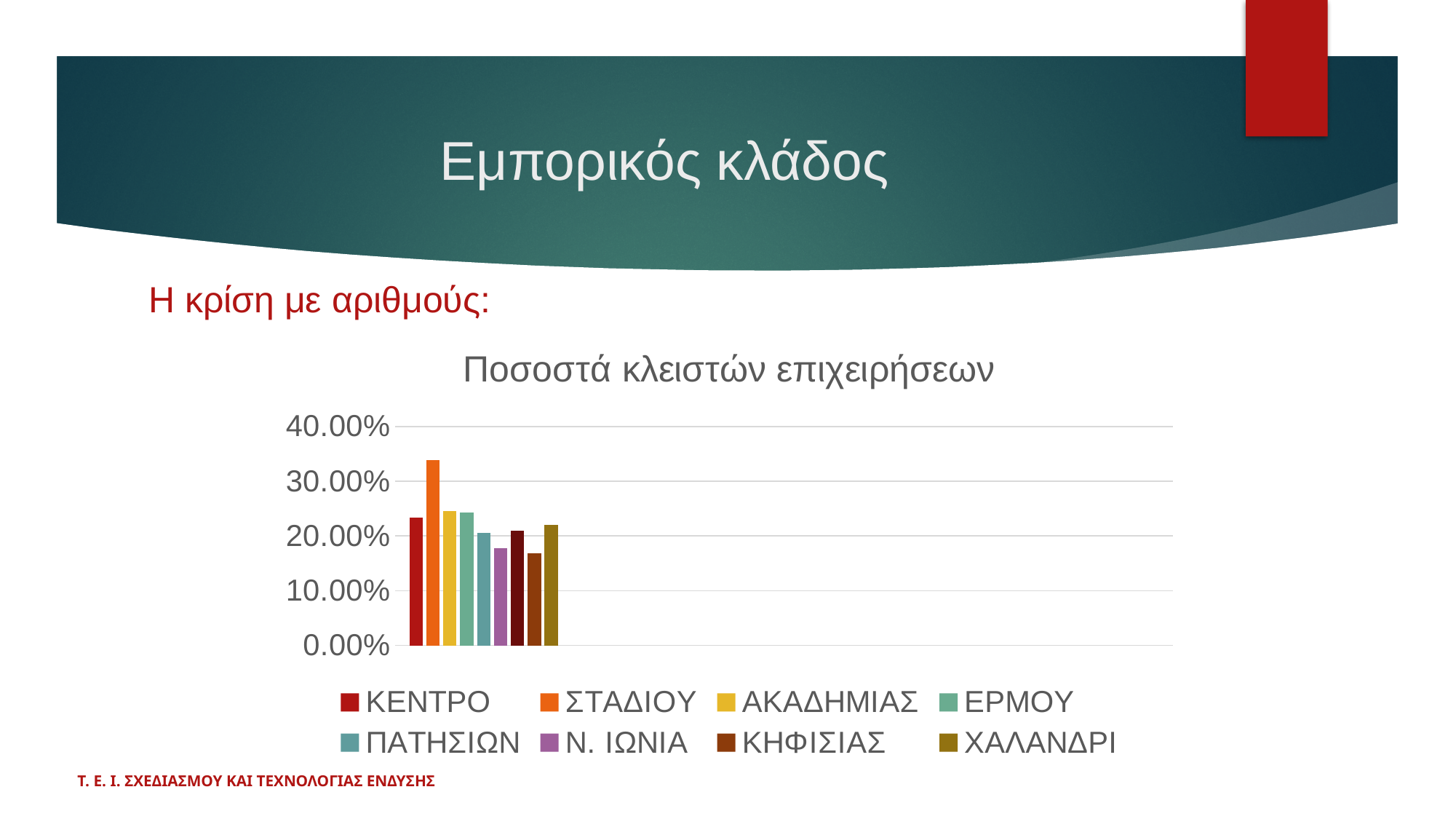
Is the value for ΚΕΝΤΡΟ greater or less than 20.00%? greater Which is larger, the value for ΣΤΑΔΙΟΥ or the value for ΚΕΝΤΡΟ? ΣΤΑΔΙΟΥ Which is larger, the value for ΚΕΝΤΡΟ or the value for Ν. ΙΩΝΙΑ? ΚΕΝΤΡΟ Is the value for ΕΡΜΟΥ greater or less than 30.00%? less Which series has the highest value in the chart? ΣΤΑΔΙΟΥ Is the value for Ν. ΙΩΝΙΑ greater or less than 20.00%? less What is the title of the chart? Ποσοστά κλειστών επιχειρήσεων How many bars are plotted in the chart? 9 How many series does the chart legend list? 8 What type of chart is shown on the slide? Bar chart